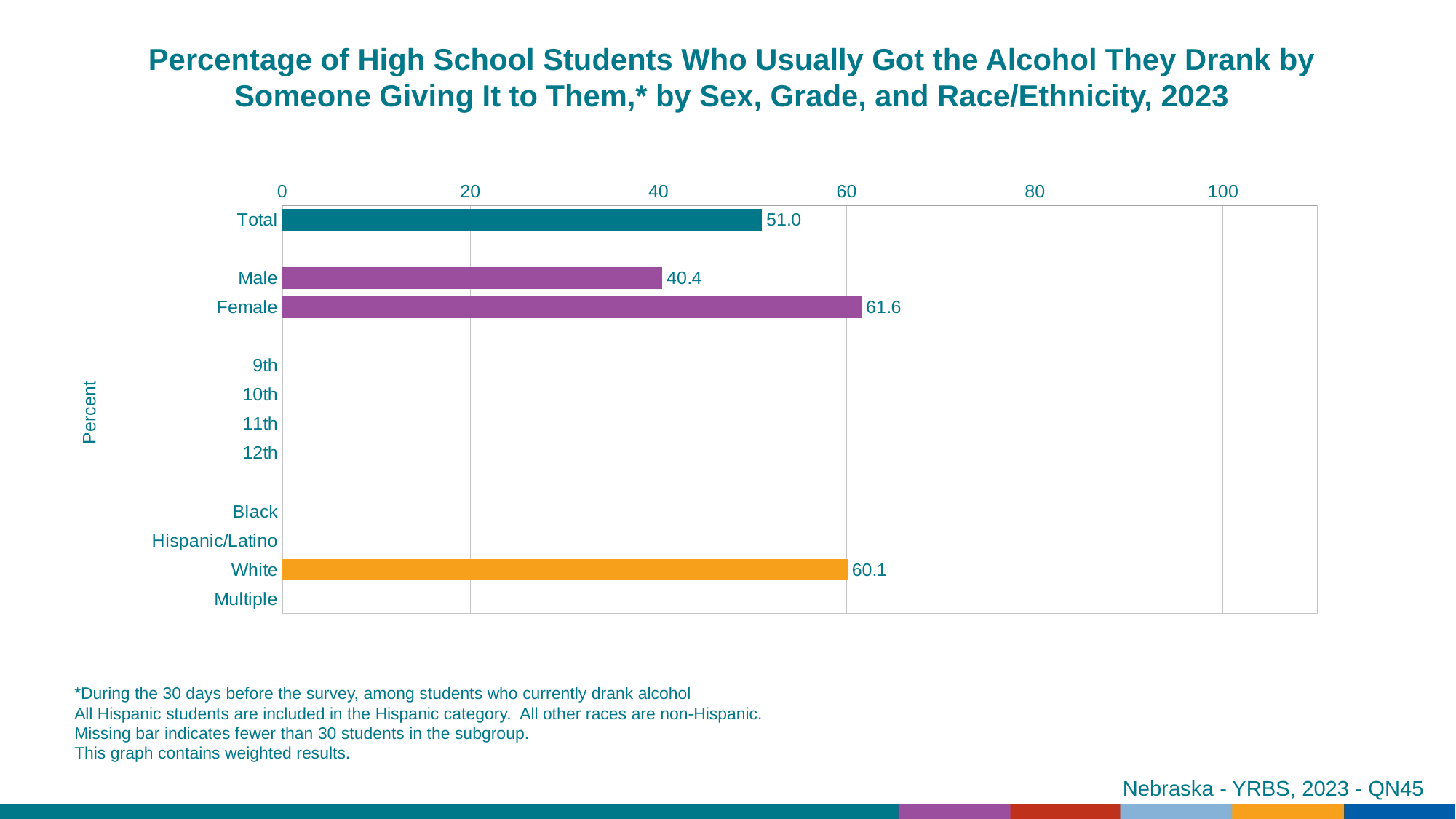
Which category with a plotted bar has the highest value? Female What is the difference between the Female and Male values? 21.2 What does a missing bar indicate, according to the note on the slide? Fewer than 30 students in the subgroup Which is larger, the value for Total or the value for White? White What is the value for Total? 51.0 What is the value for Female? 61.6 Is the value for Male greater or less than 60? less How many categories have a bar plotted on the chart? 4 Which category with a plotted bar has the lowest value? Male What is the value for Male? 40.4 What is the value for White? 60.1 What kind of chart is shown on the slide? bar chart